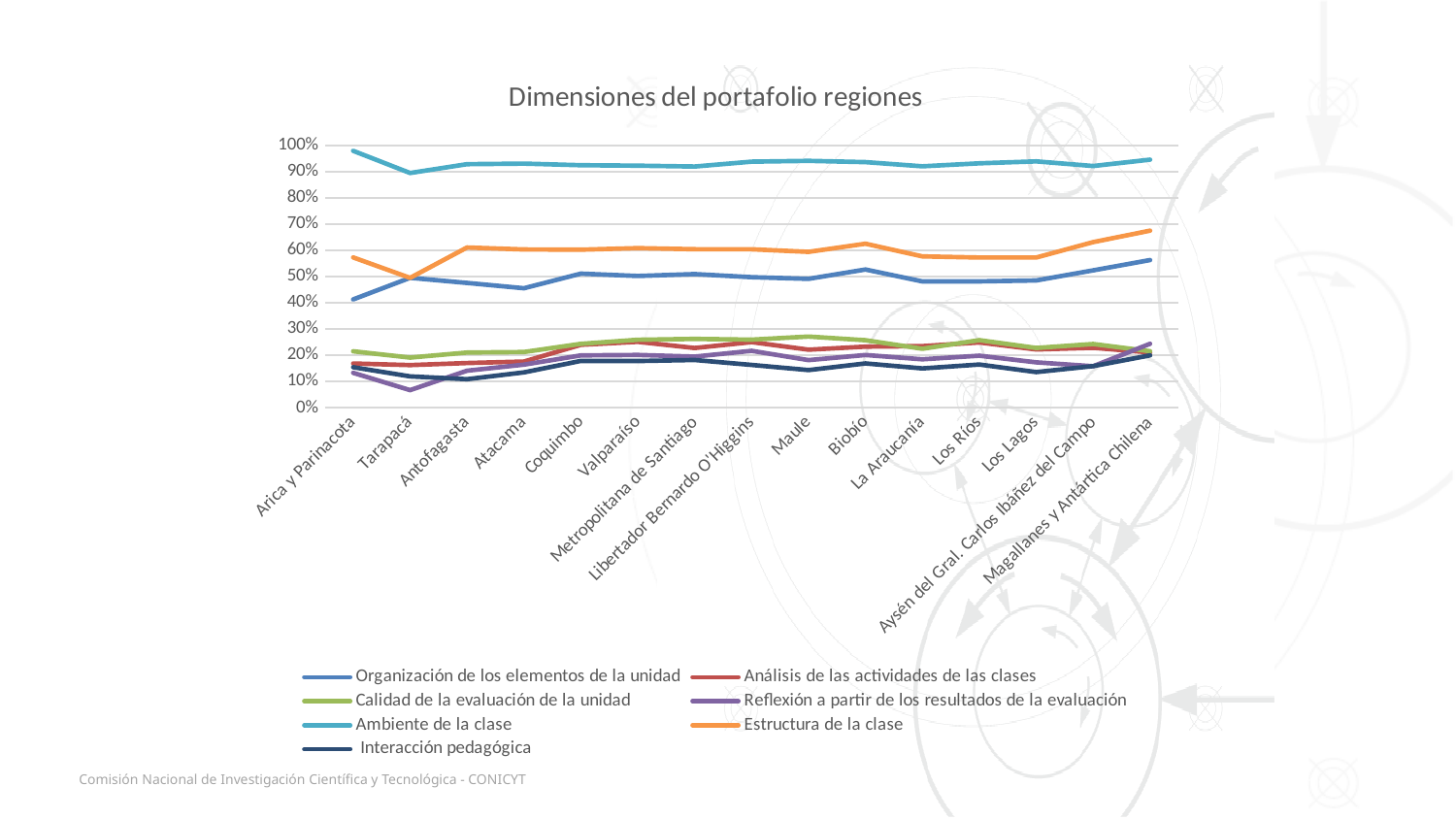
In which region is the value for Ambiente de la clase lowest? Tarapacá Which series has the highest values across all regions? Ambiente de la clase In which region is the value for Estructura de la clase highest? Magallanes y Antártica Chilena In Arica y Parinacota, which is larger: Estructura de la clase or Organización de los elementos de la unidad? Estructura de la clase Is the value for Estructura de la clase in Magallanes y Antártica Chilena greater or less than 60%? greater What kind of chart is shown on the slide? Line chart How many series does the legend list? 7 What is the title of the chart? Dimensiones del portafolio regiones How many regions are plotted along the x axis? 15 In which region is the value for Reflexión a partir de los resultados de la evaluación lowest? Tarapacá Is the value for Ambiente de la clase in Arica y Parinacota greater or less than 90%? greater Does the value for Organización de los elementos de la unidad rise or fall overall from Arica y Parinacota to Magallanes y Antártica Chilena? Rise